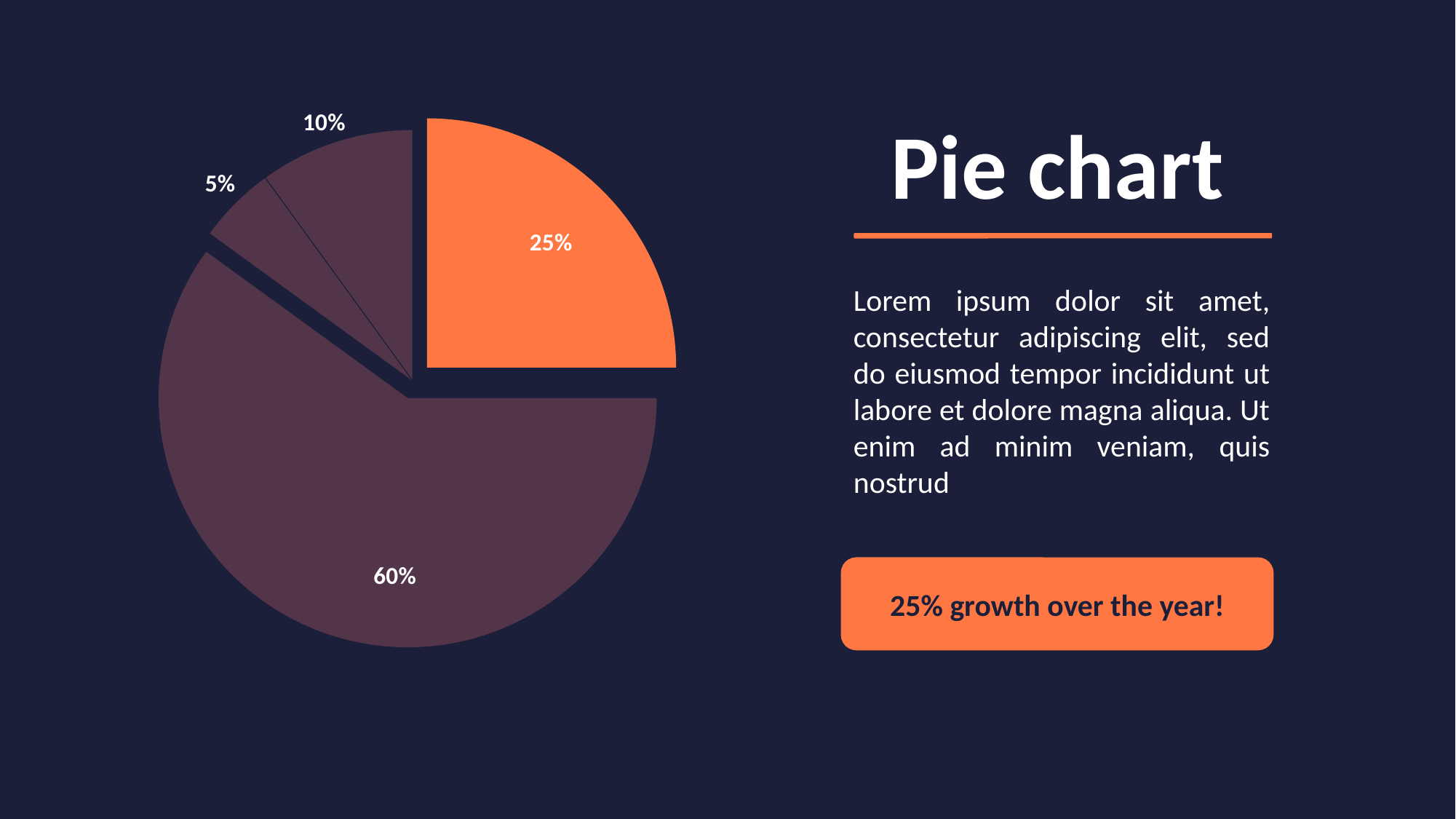
What is the value of the orange slice that is pulled out from the pie chart? 25% What is the difference between the 10% slice and the 5% slice? 5% What is the value of the smallest slice of the pie chart? 5% What is the title of the chart on the slide? Pie chart What kind of chart is shown on the slide? pie chart What is the value of the largest slice of the pie chart? 60% What is the combined share of the two smallest slices of the pie chart? 15% What is the difference between the largest slice and the orange exploded slice? 35% What does the highlighted box below the text on the slide say? 25% growth over the year! How many slices does the pie chart have? 4 What colour is the exploded slice of the pie chart? orange Which is larger, the orange exploded slice or the 10% slice? the orange exploded slice